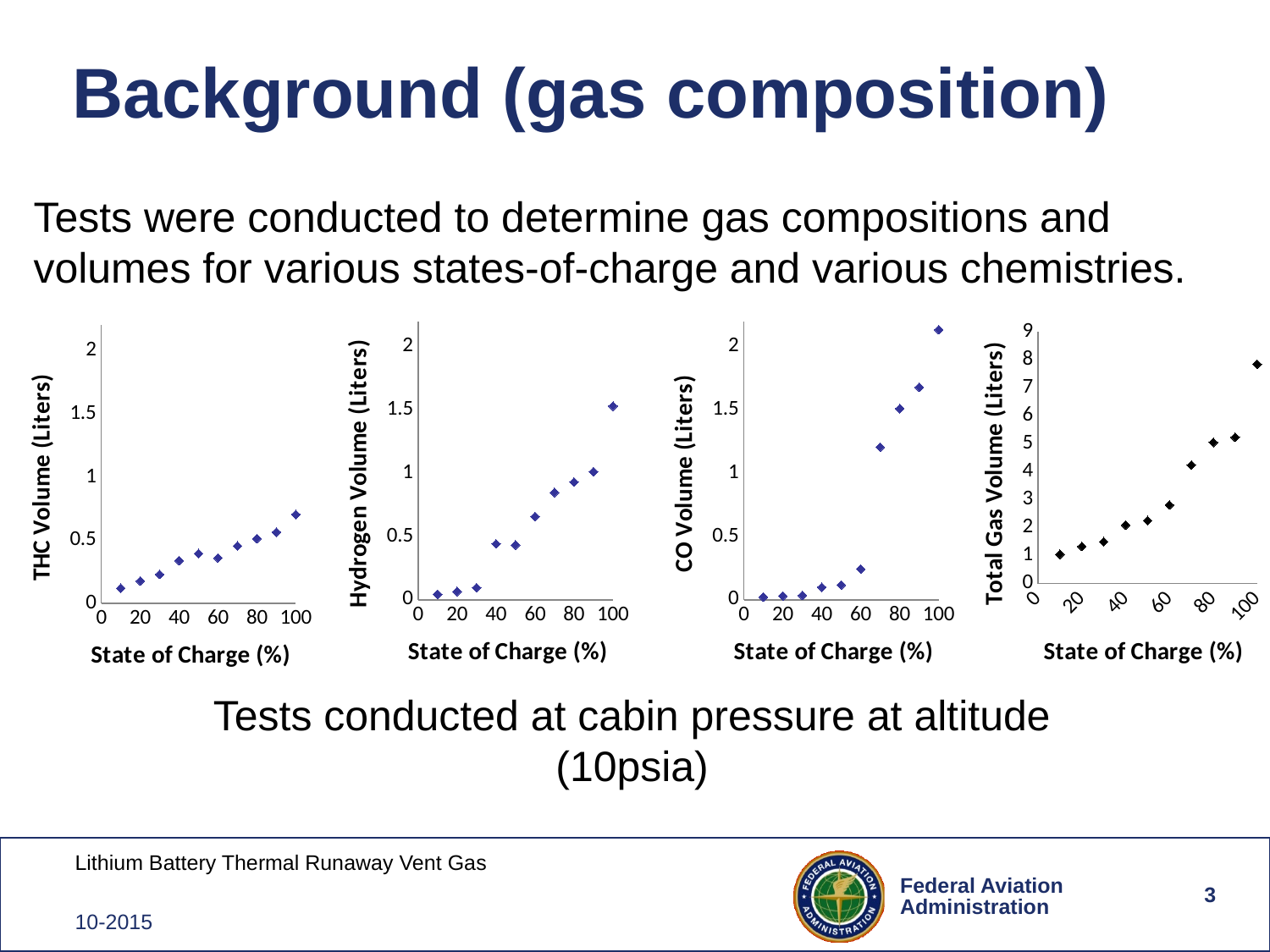
In the Total Gas Volume chart, is the value at 100% State of Charge greater or less than 7? greater In the THC Volume chart, do the values rise or fall as State of Charge increases? rise In the Hydrogen Volume chart, is the value at 10% State of Charge greater or less than 0.5? less How many data points are plotted in the CO Volume chart? 10 What is the x-axis label shared by all four charts? State of Charge (%) In the Hydrogen Volume chart, do the values rise or fall as State of Charge increases? rise In the CO Volume chart, is the value at 100% State of Charge greater or less than 2? greater In the CO Volume chart, which State of Charge has the highest CO volume? 100 In the CO Volume chart, do the values rise or fall as State of Charge increases? rise What kind of chart is the leftmost chart (THC Volume)? scatter chart